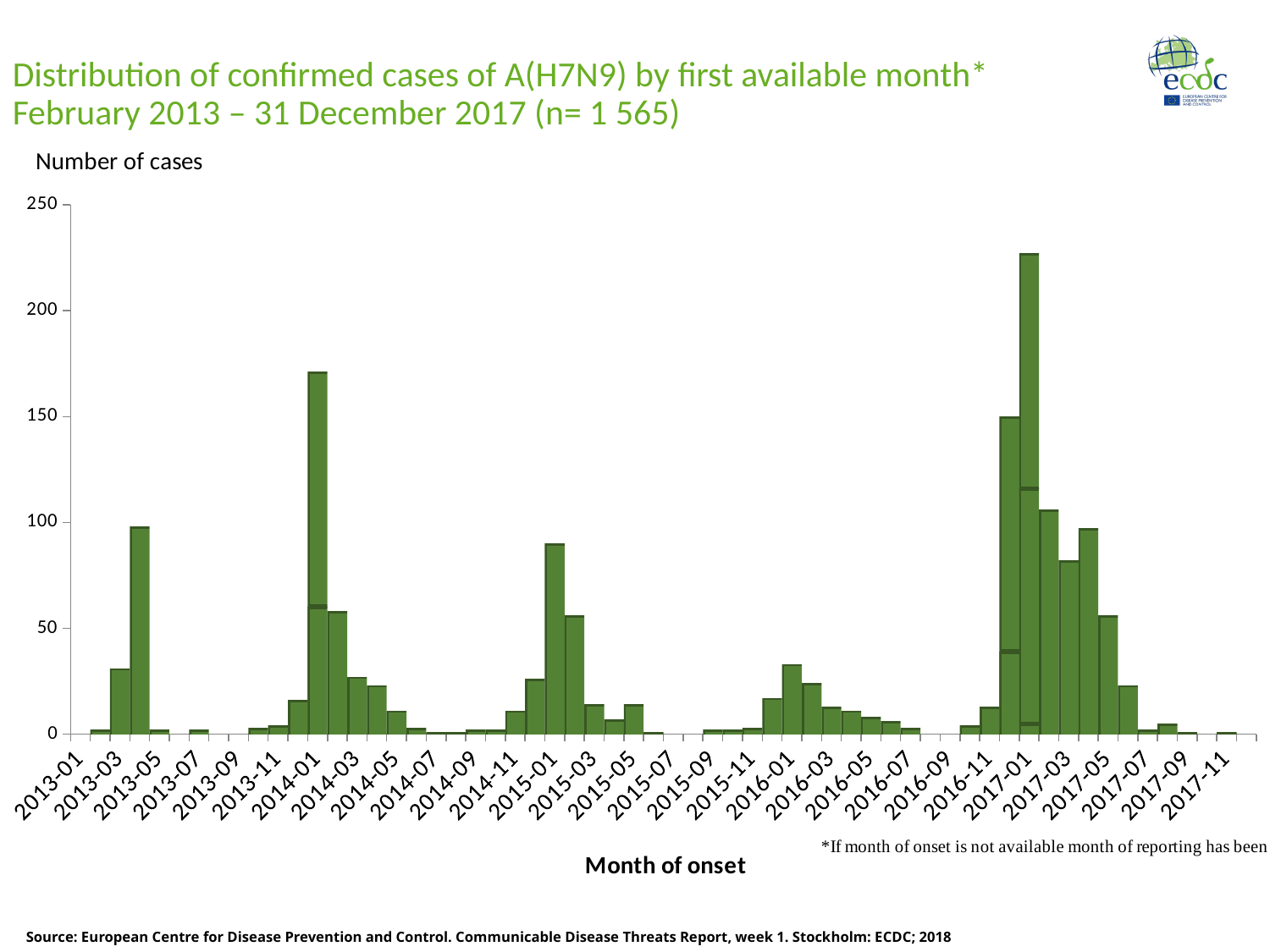
What is the highest value shown on the y axis? 250 Is the number of cases for 2015-01 greater or less than 50? greater Is the number of cases for 2015-01 greater or less than 100? less What kind of chart is shown on the slide? bar chart Which month has the highest number of cases? 2017-01 Is the number of cases for 2016-01 greater or less than 50? less What is the label of the x axis? Month of onset Which month has more cases, 2017-01 or 2014-01? 2017-01 Which month has more cases, 2014-01 or 2015-01? 2014-01